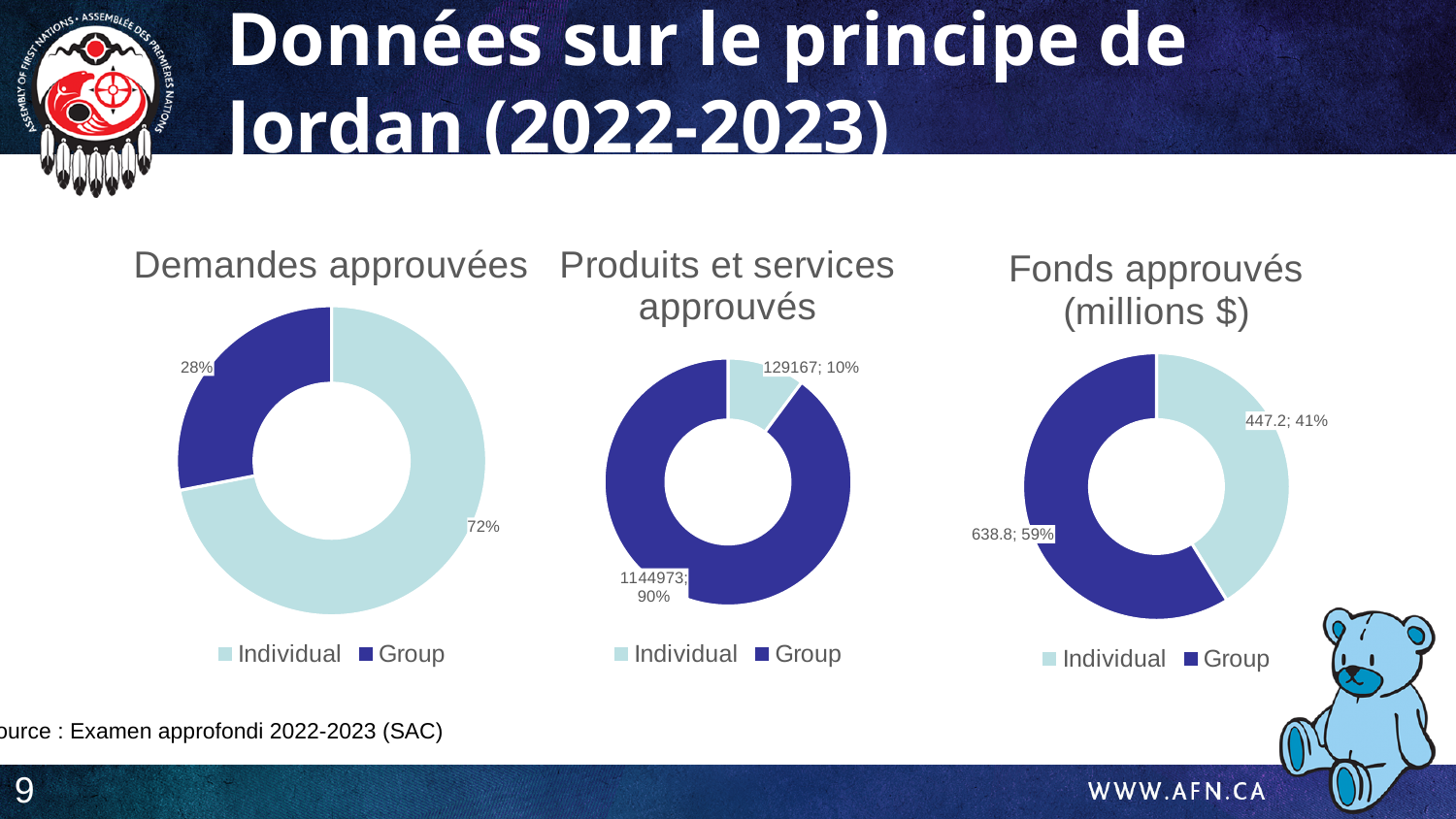
In the 'Produits et services approuvés' chart, what value is labelled for Group? 1144973 In the 'Fonds approuvés (millions $)' chart, what value is labelled for Individual? 447.2 In the 'Produits et services approuvés' chart, what percentage is labelled for Individual? 10% In the 'Demandes approuvées' chart, which category has the larger share? Individual In the 'Fonds approuvés (millions $)' chart, which is larger, Individual or Group? Group How many entries does the legend of the 'Fonds approuvés (millions $)' chart list? 2 In the 'Fonds approuvés (millions $)' chart, what is the difference between the Group value and the Individual value? 191.6 In the 'Demandes approuvées' chart, what share is labelled for Group? 28% In the 'Fonds approuvés (millions $)' chart, what percentage is labelled for Group? 59% What kind of chart is used for 'Demandes approuvées'? Donut chart In the 'Demandes approuvées' chart, what share is labelled for Individual? 72% In the 'Produits et services approuvés' chart, what is the difference between the Group value and the Individual value? 1015806